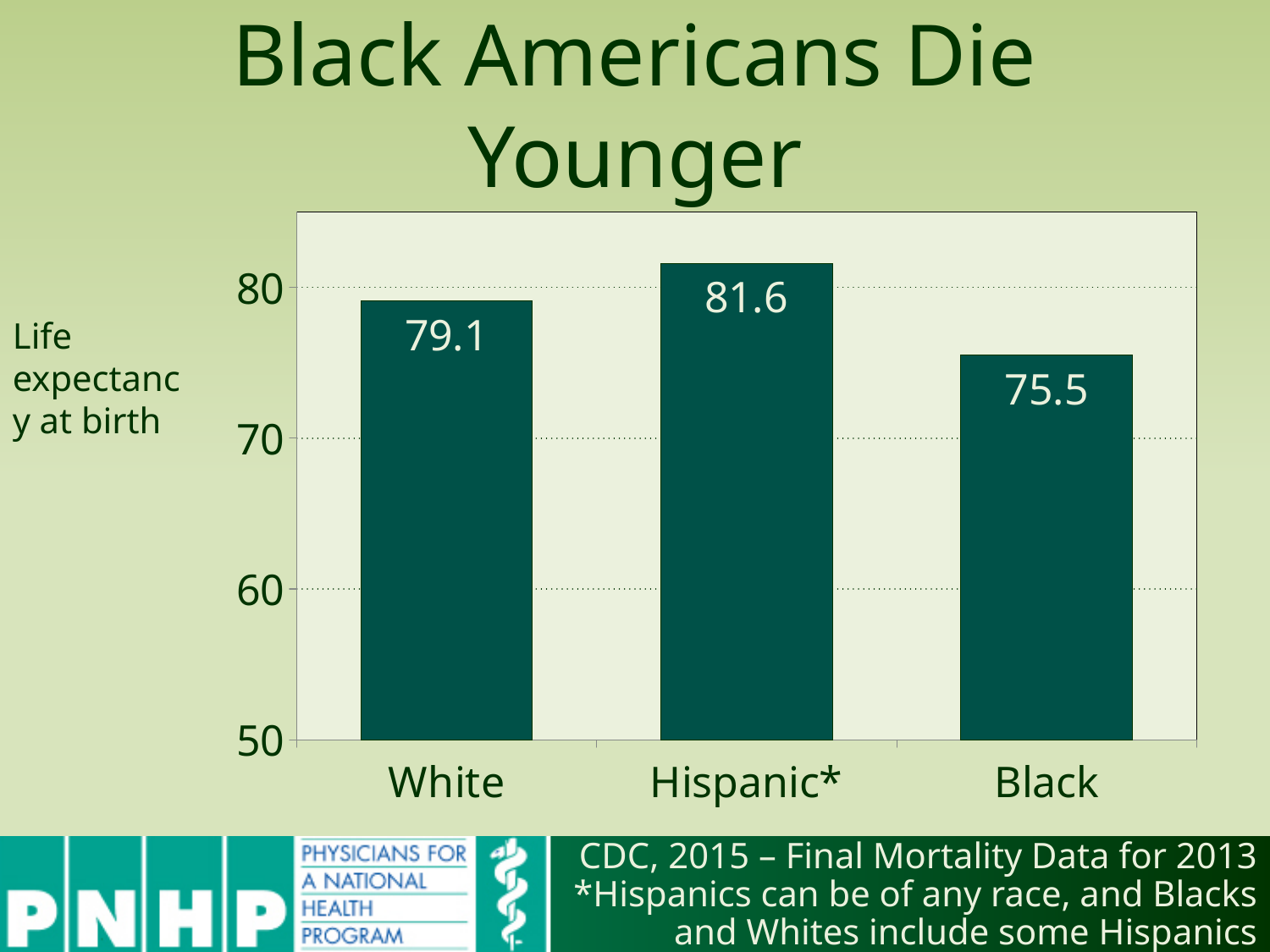
What kind of chart is shown on the slide? bar chart Which group has a higher life expectancy, White or Black? White What is the life expectancy at birth for Hispanic Americans? 81.6 Which group has the lowest life expectancy at birth? Black What is the life expectancy at birth for Black Americans? 75.5 How many groups are shown in the chart? 3 What is the life expectancy at birth for White Americans? 79.1 What is the difference in life expectancy between White and Black Americans? 3.6 Which group has the highest life expectancy at birth? Hispanic* What is the title of the slide? Black Americans Die Younger Is the life expectancy for Hispanic Americans greater or less than 80? greater What is the difference in life expectancy between Hispanic and Black Americans? 6.1